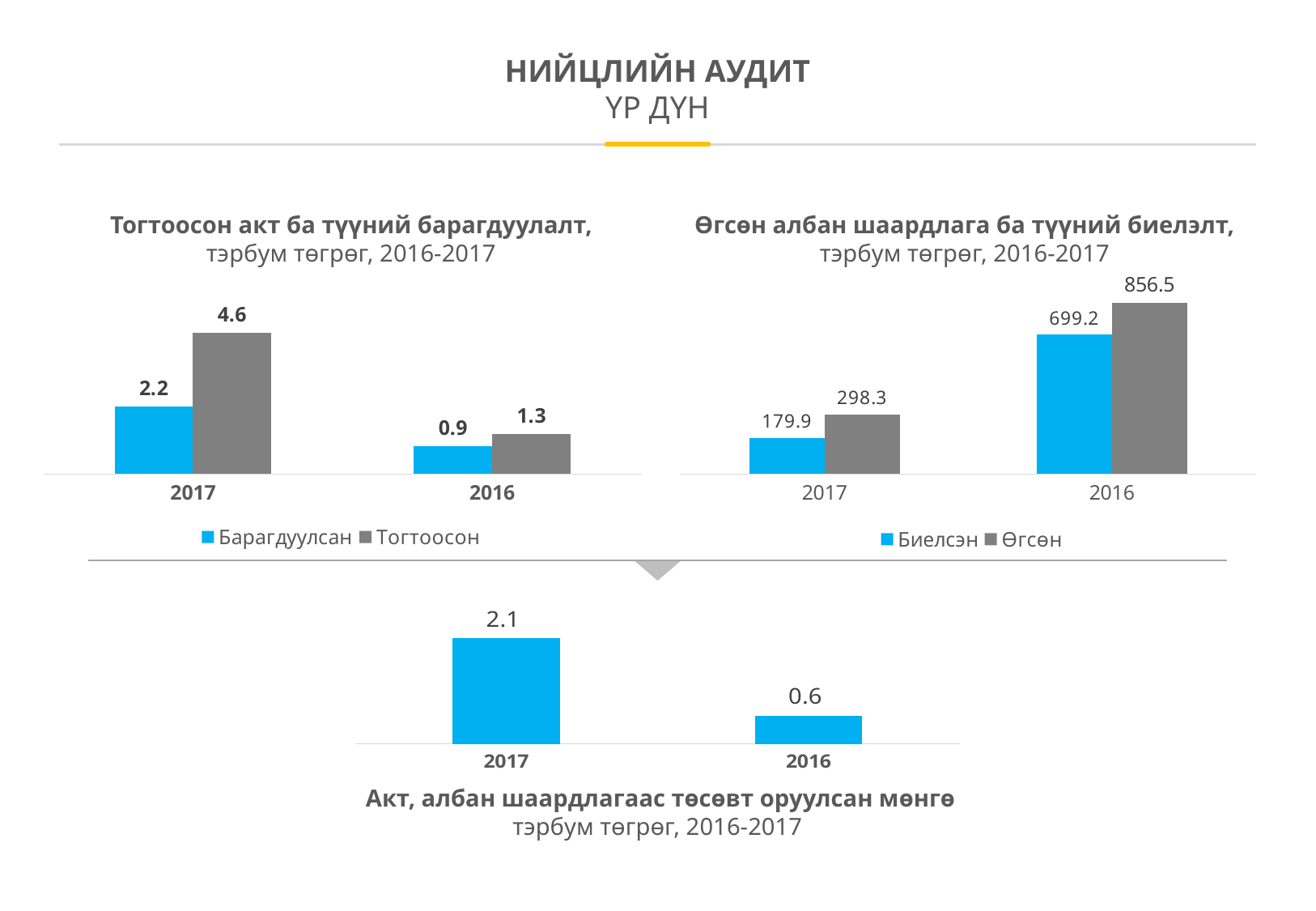
In the bottom chart 'Акт, албан шаардлагаас төсөвт оруулсан мөнгө', what is the value for 2017? 2.1 In the top-right chart 'Өгсөн албан шаардлага ба түүний биелэлт', which year has the highest Өгсөн value? 2016 In the top-left chart 'Тогтоосон акт ба түүний барагдуулалт', how many series does the legend list? 2 In the top-left chart 'Тогтоосон акт ба түүний барагдуулалт', what is the value of Барагдуулсан for 2016? 0.9 In the top-right chart 'Өгсөн албан шаардлага ба түүний биелэлт', what is the value of Өгсөн for 2016? 856.5 In the top-left chart 'Тогтоосон акт ба түүний барагдуулалт', what is the difference between Тогтоосон and Барагдуулсан in 2017? 2.4 In the top-right chart 'Өгсөн албан шаардлага ба түүний биелэлт', which is larger: Биелсэн in 2016 or Өгсөн in 2017? Биелсэн in 2016 In the top-right chart 'Өгсөн албан шаардлага ба түүний биелэлт', what is the difference between Өгсөн and Биелсэн in 2016? 157.3 What type of chart is the bottom chart 'Акт, албан шаардлагаас төсөвт оруулсан мөнгө'? Bar chart In the bottom chart 'Акт, албан шаардлагаас төсөвт оруулсан мөнгө', what is the difference between 2017 and 2016? 1.5 In the top-left chart 'Тогтоосон акт ба түүний барагдуулалт', what is the value of Тогтоосон for 2017? 4.6 In the top-right chart 'Өгсөн албан шаардлага ба түүний биелэлт', what is the value of Биелсэн for 2017? 179.9